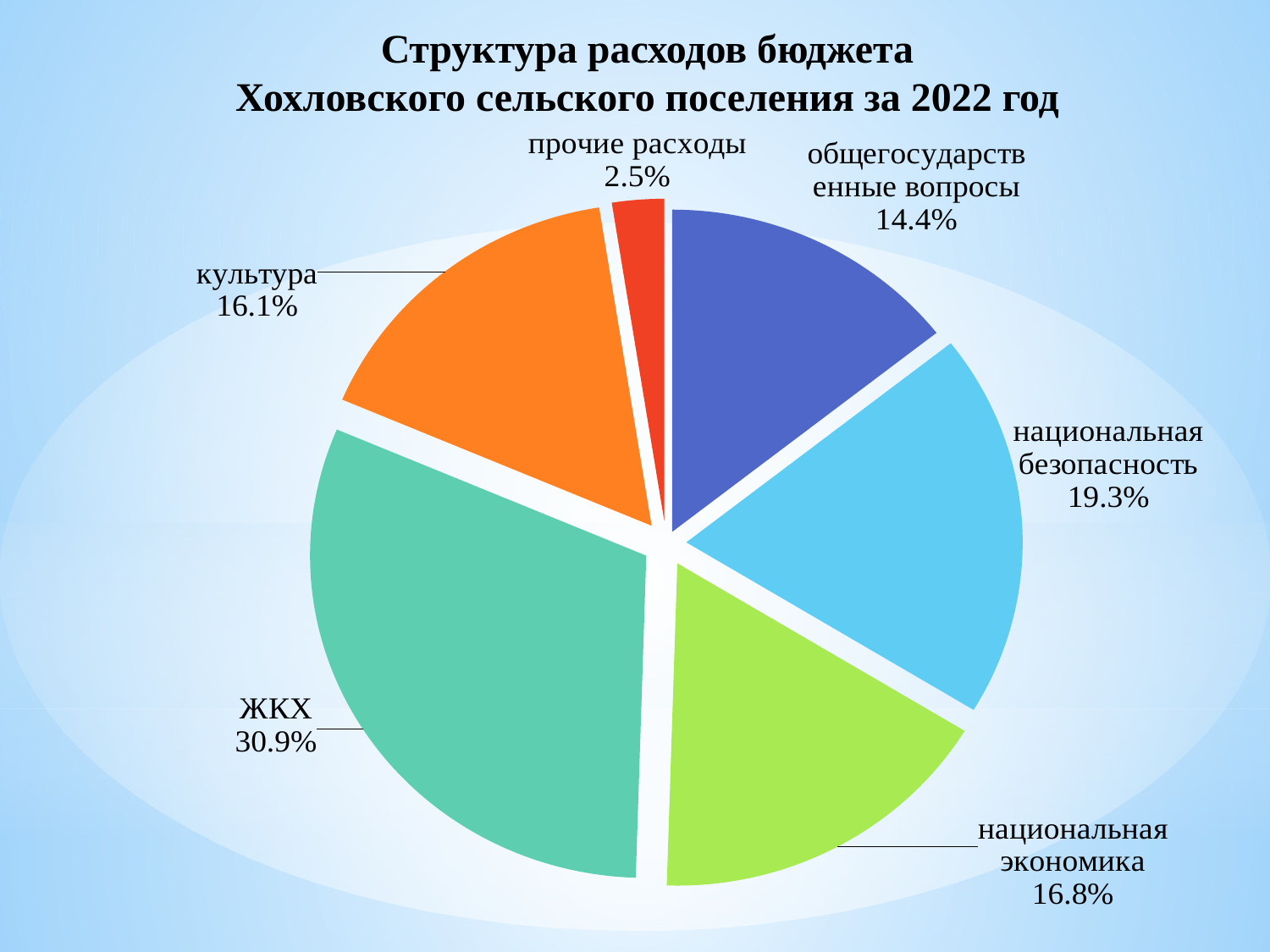
What colour is the slice for национальная экономика? light green Which category has the smallest share of expenditures? прочие расходы What is the title of the chart? Структура расходов бюджета Хохловского сельского поселения за 2022 год What share of budget expenditures goes to ЖКХ? 30.9% How many categories does the pie chart show? 6 What is the value for прочие расходы? 2.5% What percentage is shown for культура? 16.1% What is the difference between the shares of ЖКХ and национальная безопасность? 11.6% What is the value for национальная безопасность? 19.3% Which is larger: национальная экономика or общегосударственные вопросы? национальная экономика What type of chart is shown on the slide? pie chart Which category has the largest share of expenditures? ЖКХ